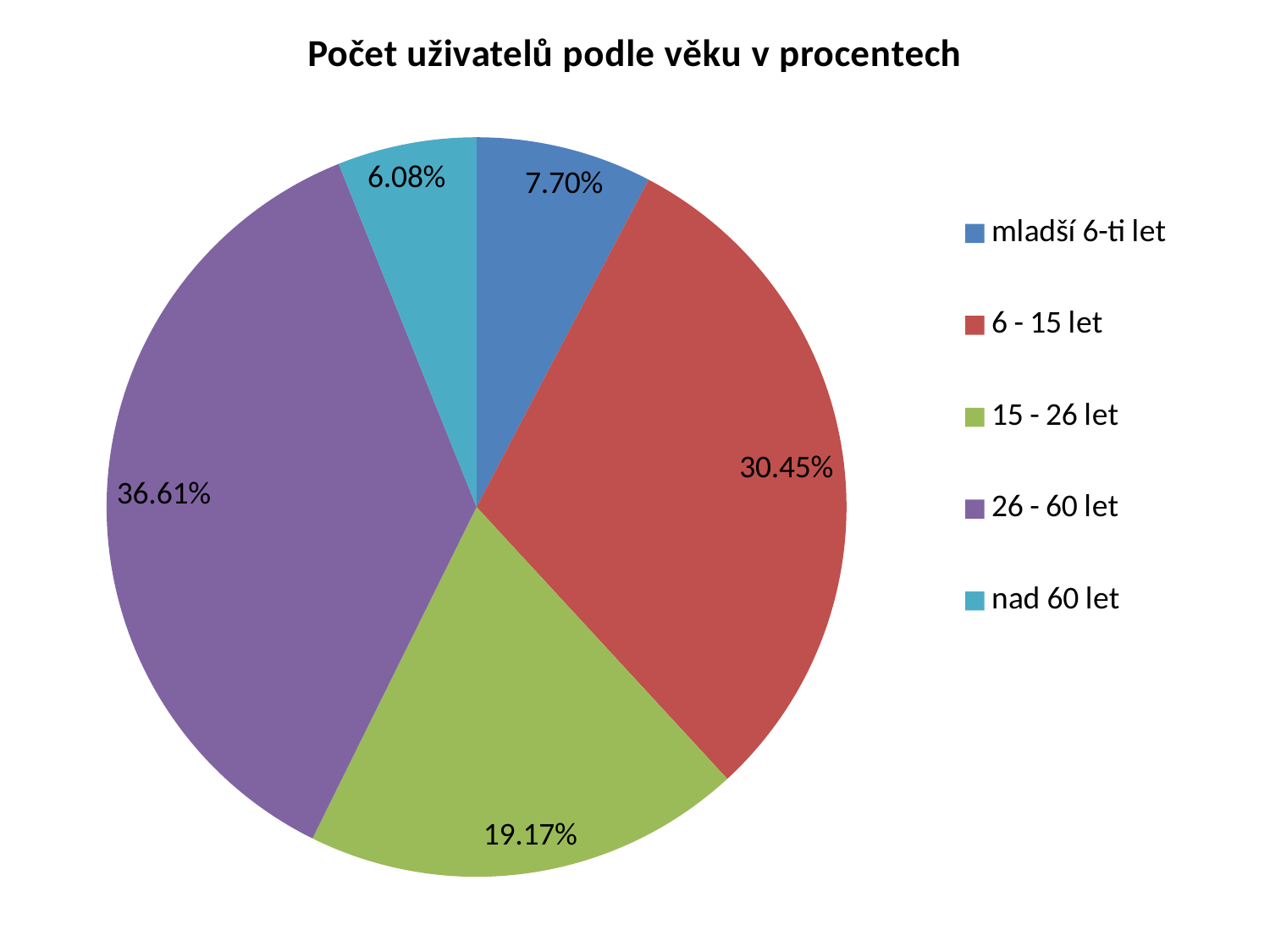
What kind of chart is shown on the slide? pie chart What is the title of the chart? Počet uživatelů podle věku v procentech What is the value shown for '15 - 26 let'? 19.17% What is the difference between the shares of '26 - 60 let' and '6 - 15 let'? 6.16% What is the value shown for '6 - 15 let'? 30.45% What is the value shown for 'mladší 6-ti let'? 7.70% Which age group has the largest share of users? 26 - 60 let What is the value shown for 'nad 60 let'? 6.08% How many age categories does the pie chart show? 5 Which is larger, the share for '15 - 26 let' or the share for 'mladší 6-ti let'? 15 - 26 let What share of the pie does the '26 - 60 let' slice represent? 36.61% Which age group has the smallest share of users? nad 60 let